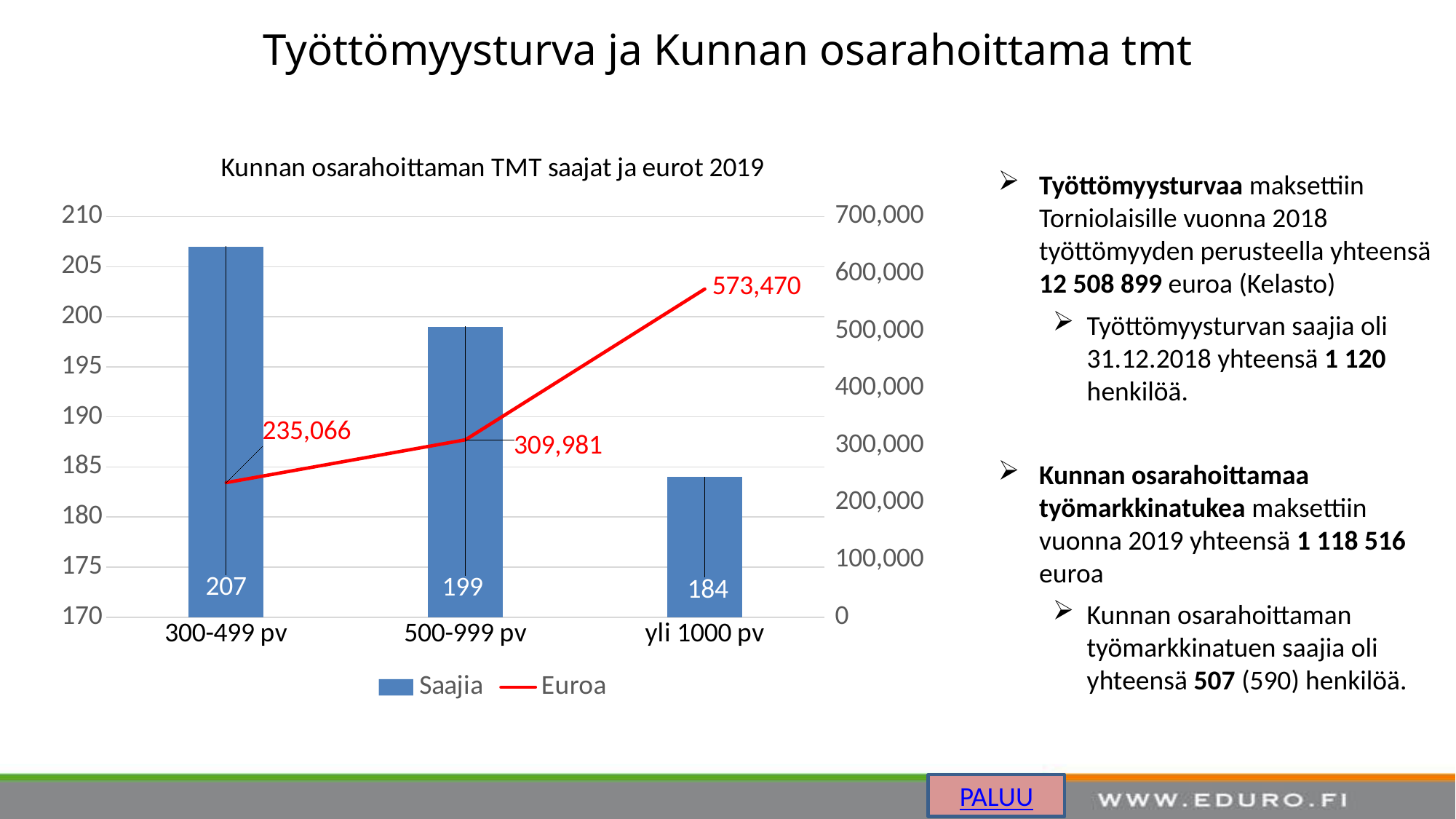
Which category has the lowest Euroa value? 300-499 pv What is the Euroa value for the yli 1000 pv category? 573,470 What is the Saajia value for the 300-499 pv category? 207 Does the Euroa series rise or fall from 300-499 pv to yli 1000 pv? rise How many series does the legend list? 2 What is the Euroa value for the 500-999 pv category? 309,981 Which category has the highest Saajia value? 300-499 pv What is the title of the chart? Kunnan osarahoittaman TMT saajat ja eurot 2019 What is the difference in Saajia between 300-499 pv and yli 1000 pv? 23 How many categories are shown on the x axis? 3 Which is larger, the Saajia value for 500-999 pv or for yli 1000 pv? 500-999 pv What is the difference in Euroa between yli 1000 pv and 500-999 pv? 263,489